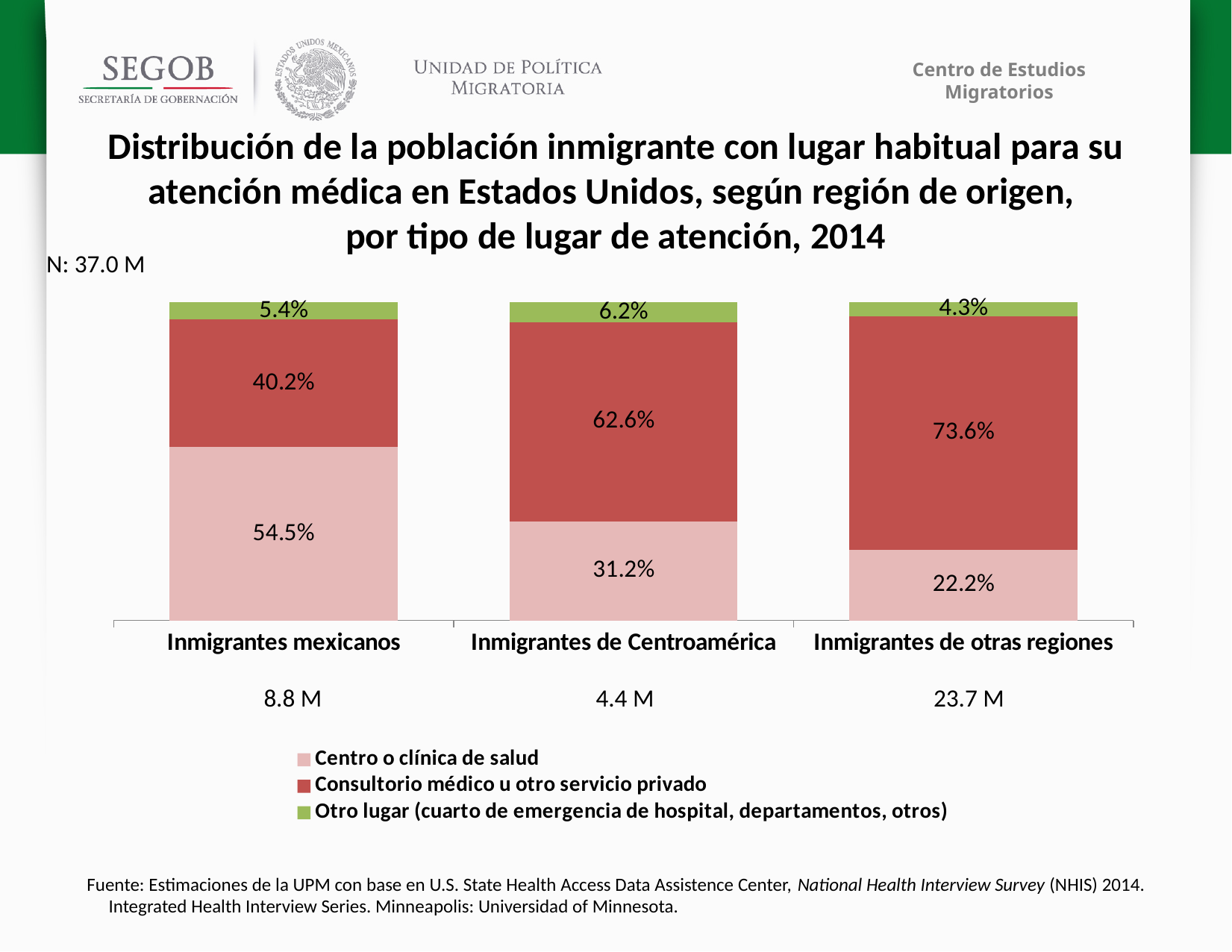
What is the total of the stacked bar for Inmigrantes de Centroamérica? 100.0% What type of chart is shown on the slide? Stacked bar chart How many series does the legend list? 3 What is the value for Consultorio médico u otro servicio privado among Inmigrantes de otras regiones? 73.6% Which group has the highest share for Consultorio médico u otro servicio privado? Inmigrantes de otras regiones How many immigrant groups (categories) are shown on the x axis? 3 Which group has the lowest share for Centro o clínica de salud? Inmigrantes de otras regiones What is the difference in the Consultorio médico u otro servicio privado share between Inmigrantes de otras regiones and Inmigrantes mexicanos? 33.4 percentage points Which is larger: the Centro o clínica de salud share for Inmigrantes mexicanos or for Inmigrantes de Centroamérica? Inmigrantes mexicanos What is the value for Otro lugar among Inmigrantes de Centroamérica? 6.2% What population size is shown below the Inmigrantes de otras regiones bar? 23.7 M What percentage of Mexican immigrants (Inmigrantes mexicanos) use a Centro o clínica de salud as their usual place of care? 54.5%